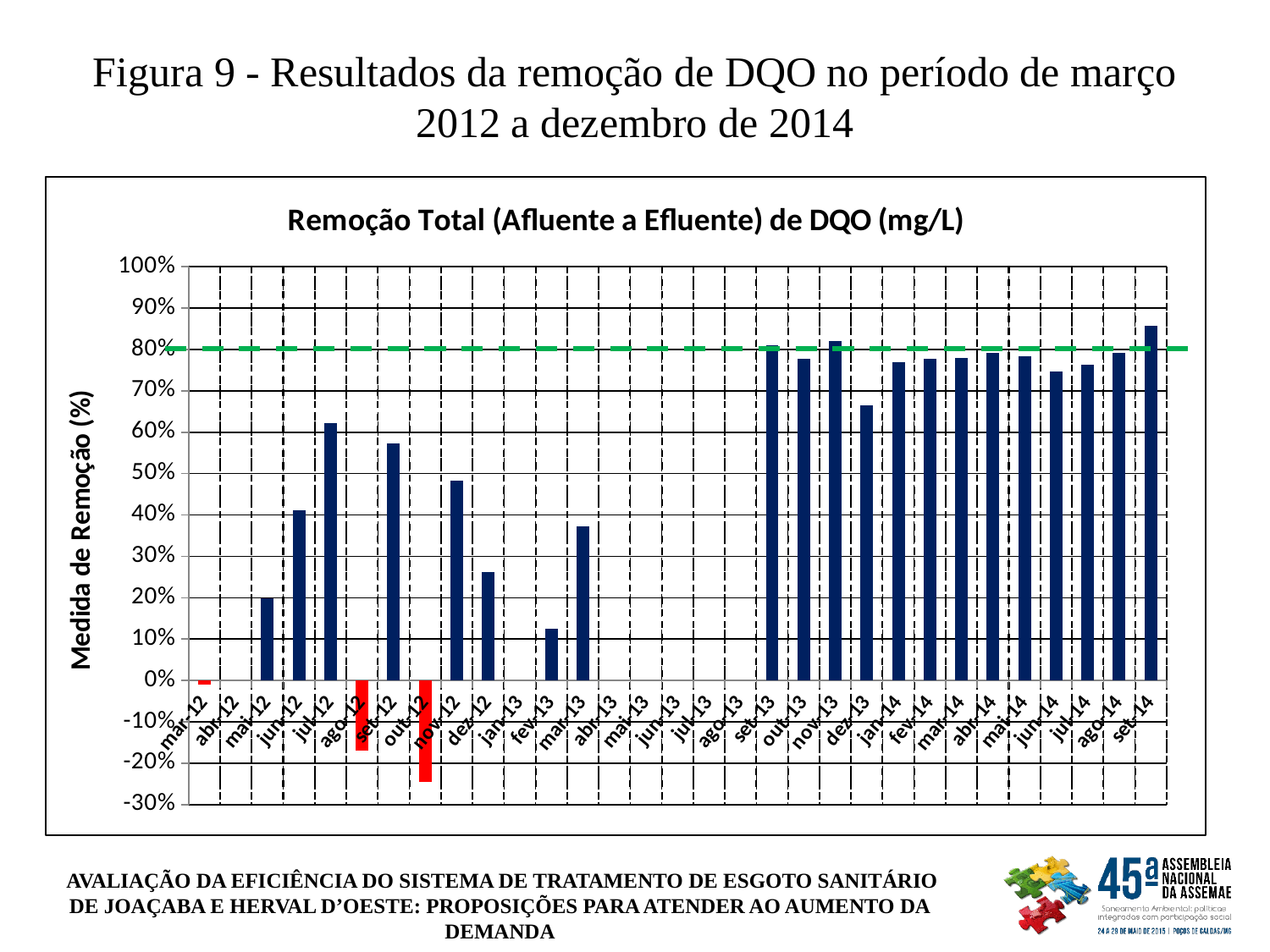
Is the value for dez-13 greater or less than 70%? less What kind of chart is shown on the slide? bar chart Do the values rise or fall from mai-12 to jul-12? rise Is the value for set-14 greater or less than 80%? greater Is the value for mai-12 greater or less than 30%? less What is the title of the chart? Remoção Total (Afluente a Efluente) de DQO (mg/L) How many month categories are labelled on the x axis of the chart? 31 Which month has the highest removal value in the chart? set-14 Which is larger, the value for jul-12 or the value for set-12? jul-12 Which month has the lowest removal value in the chart? out-12